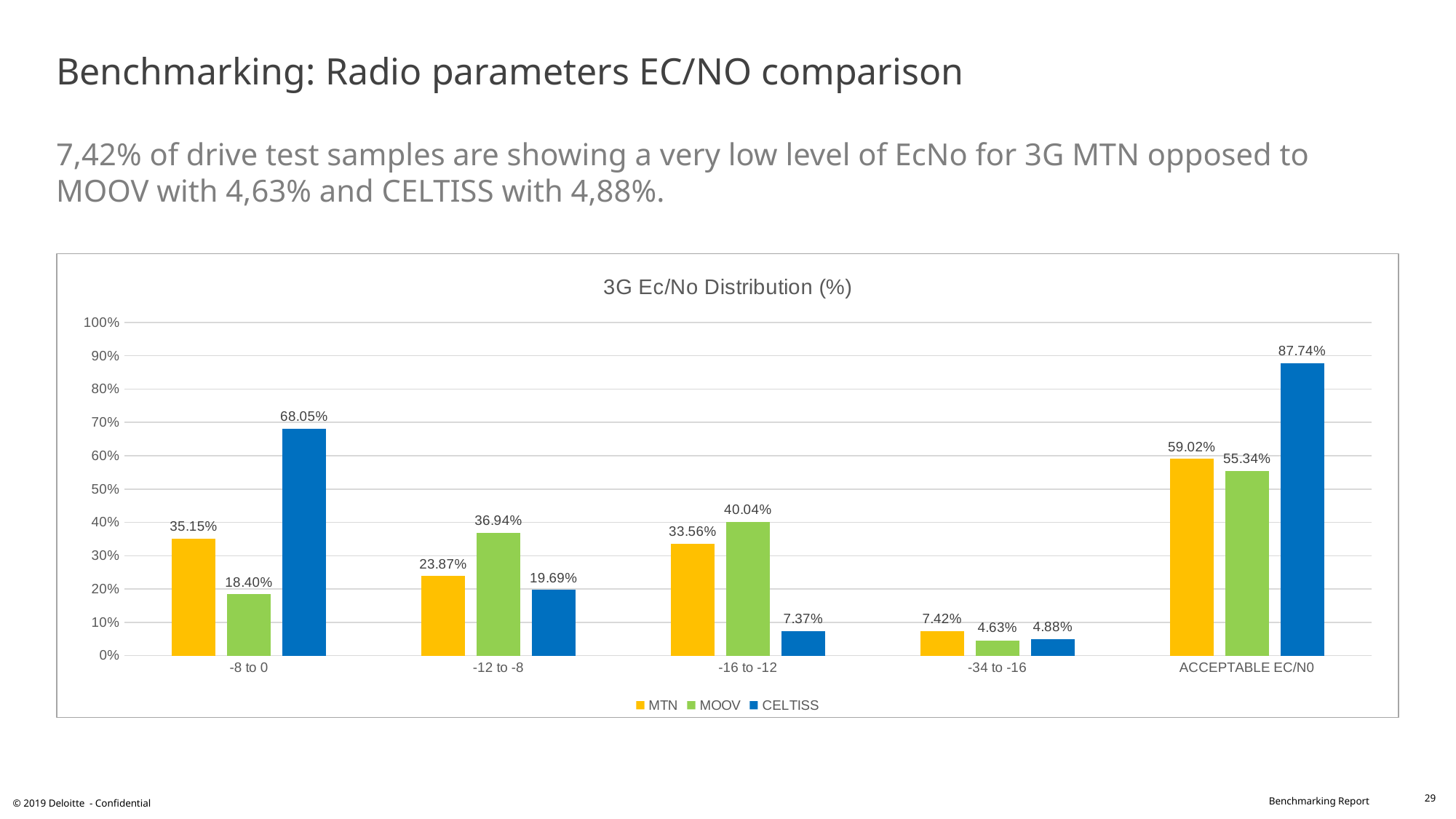
What is the value for MOOV in the -16 to -12 category? 40.04% What is the title of the chart? 3G Ec/No Distribution (%) Is the value for CELTISS in the ACCEPTABLE EC/N0 category greater or less than 80%? greater How many series does the legend list? 3 Which series has the highest value in the ACCEPTABLE EC/N0 category? CELTISS What is the value for CELTISS in the -8 to 0 category? 68.05% Which is larger in the -16 to -12 category, MTN or CELTISS? MTN What is the value for MTN in the ACCEPTABLE EC/N0 category? 59.02% What kind of chart is shown on the slide? Bar chart What is the difference between the MTN and MOOV values in the -12 to -8 category? 13.07% How many categories are shown on the x axis? 5 Which series has the lowest value in the -34 to -16 category? MOOV